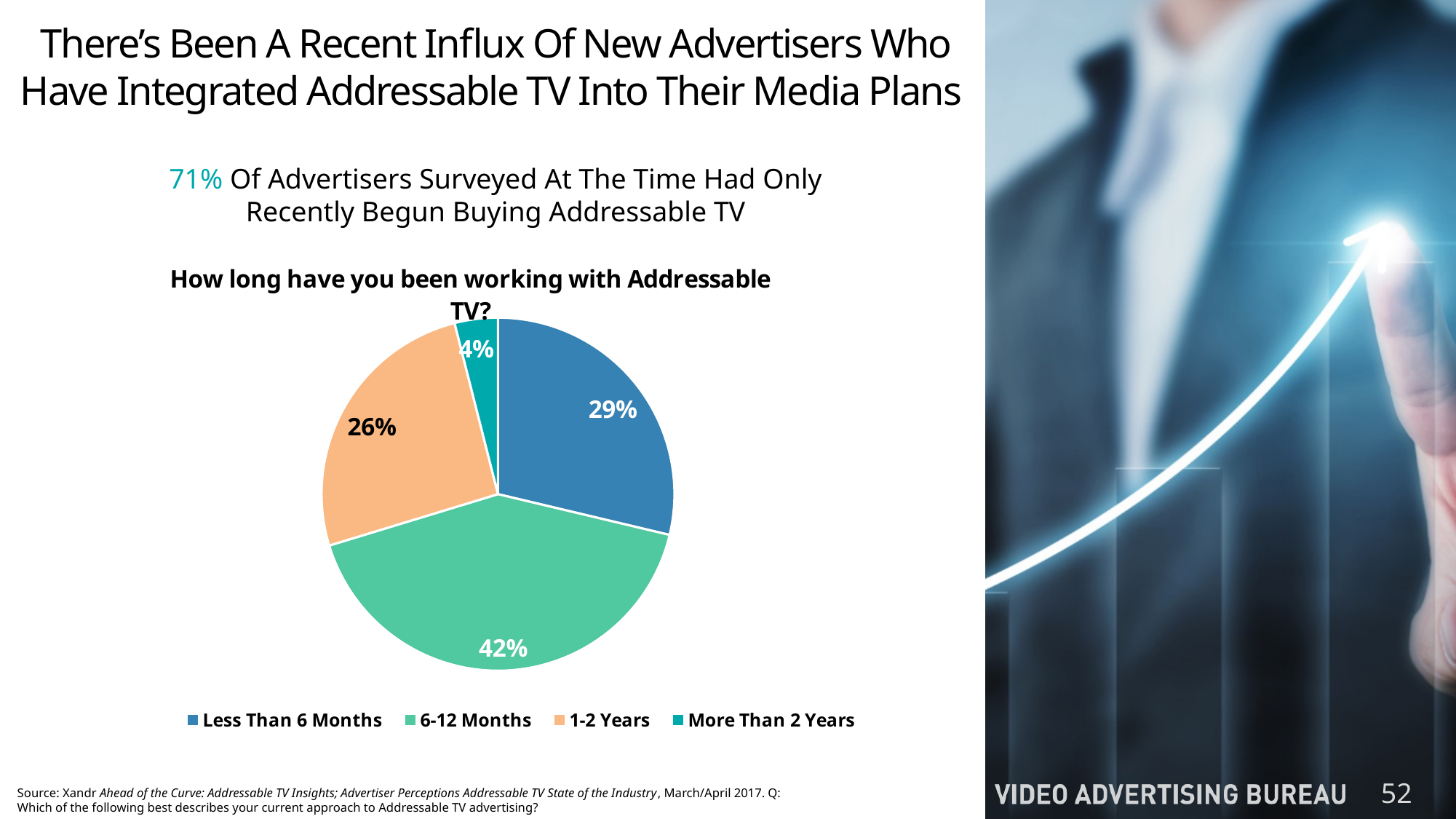
What share of advertisers have been working with Addressable TV for 1-2 years? 26% How many categories does the pie chart show? 4 Which is larger, the share for Less Than 6 Months or the share for 1-2 Years? Less Than 6 Months What share of advertisers have been working with Addressable TV for 6-12 months? 42% What is the combined share of advertisers who have worked with Addressable TV for less than a year (Less Than 6 Months plus 6-12 Months)? 71% What kind of chart is shown on the slide? pie chart What is the title of the pie chart? How long have you been working with Addressable TV? What share of advertisers have been working with Addressable TV for more than 2 years? 4% Which category has the smallest slice of the pie? More Than 2 Years What share of advertisers have been working with Addressable TV for less than 6 months? 29% Which category has the largest slice of the pie? 6-12 Months What is the difference between the 6-12 Months share and the Less Than 6 Months share? 13 percentage points